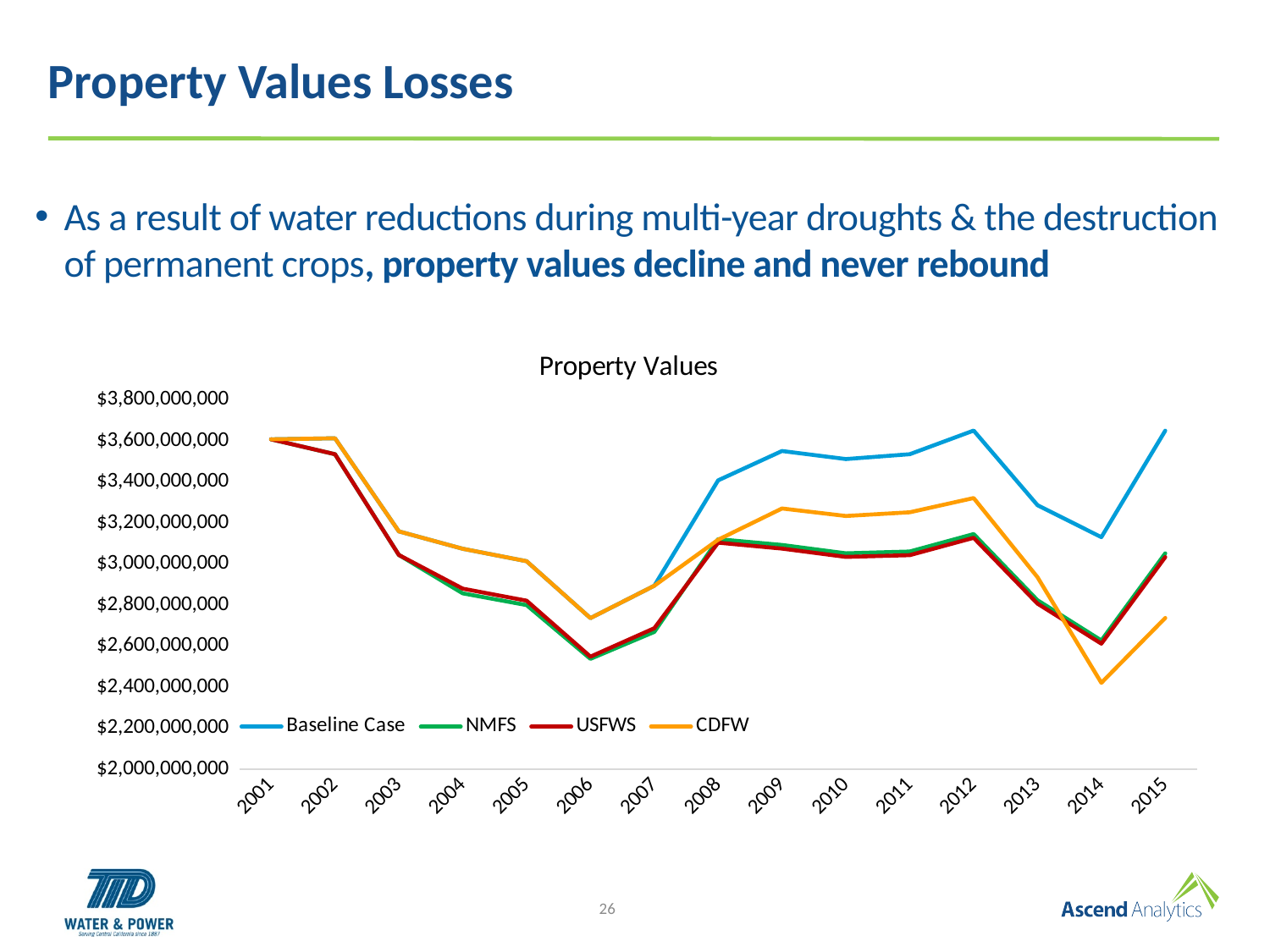
What is the title of the chart? Property Values In which year does the Baseline Case series reach its lowest value? 2006 How many series does the chart legend list? 4 Do the CDFW values rise or fall from 2002 to 2006? Fall Is the USFWS value for 2006 greater or less than $2,600,000,000? less Is the CDFW value for 2006 greater or less than $2,600,000,000? greater Is the Baseline Case value for 2014 greater or less than $3,200,000,000? less In 2014, which is larger: the Baseline Case value or the CDFW value? Baseline Case What kind of chart is shown on the slide? Line chart In which year does the CDFW series reach its lowest value? 2014 How many years are plotted along the x axis of the chart? 15 Which series is drawn in orange in the chart? CDFW